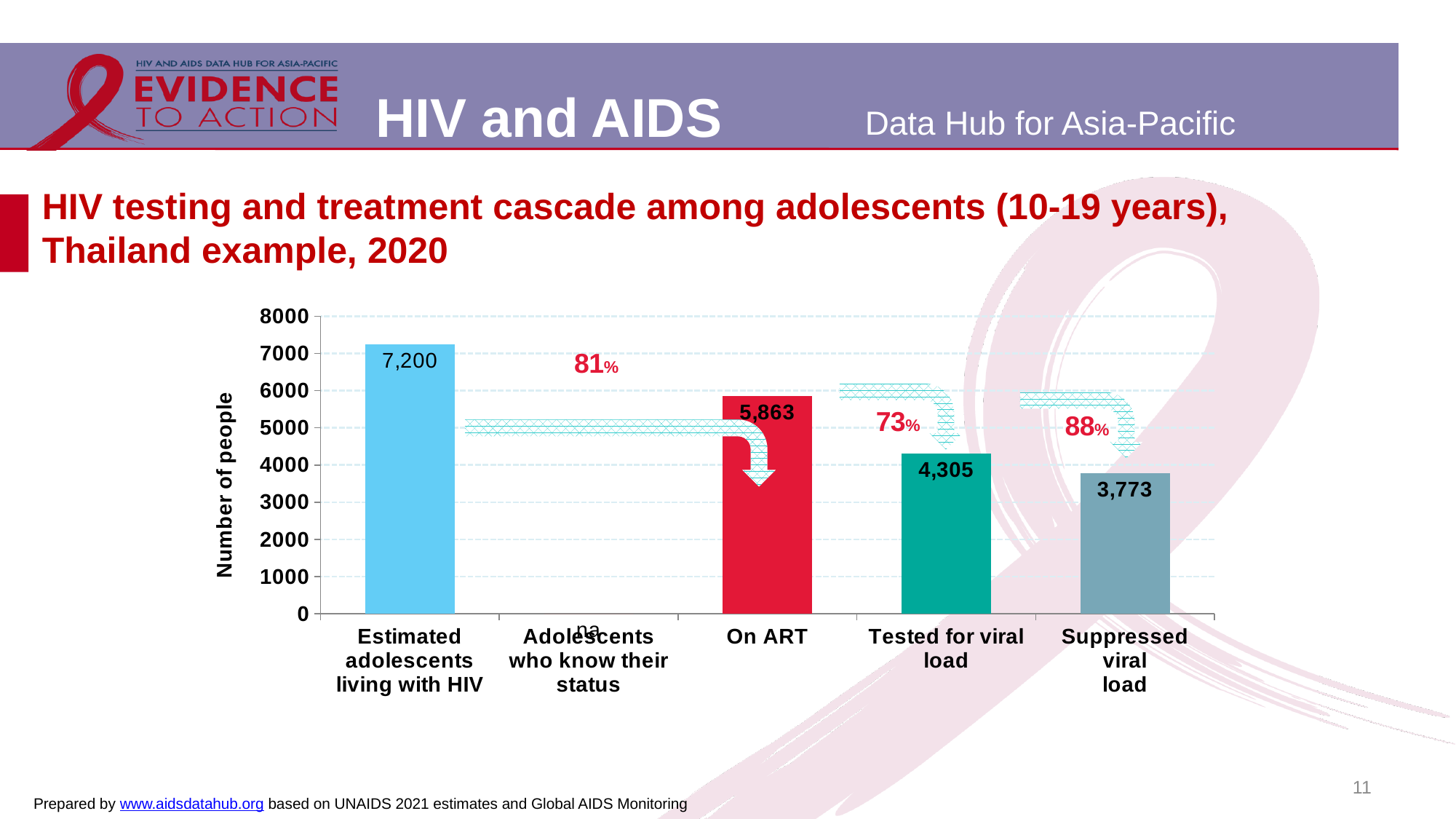
What percentage is shown between the On ART bar and the Tested for viral load bar? 73% What is the difference between the values for On ART and Tested for viral load? 1,558 What is the value for Suppressed viral load? 3,773 What kind of chart is this? Bar chart Which category with a plotted bar has the lowest value? Suppressed viral load What is the value for Tested for viral load? 4,305 How many categories are shown on the x axis? 5 What is the value for On ART? 5,863 What is shown for Adolescents who know their status? na What is the value for Estimated adolescents living with HIV? 7,200 Which is larger, the value for Tested for viral load or the value for Suppressed viral load? Tested for viral load Which category has the highest value? Estimated adolescents living with HIV